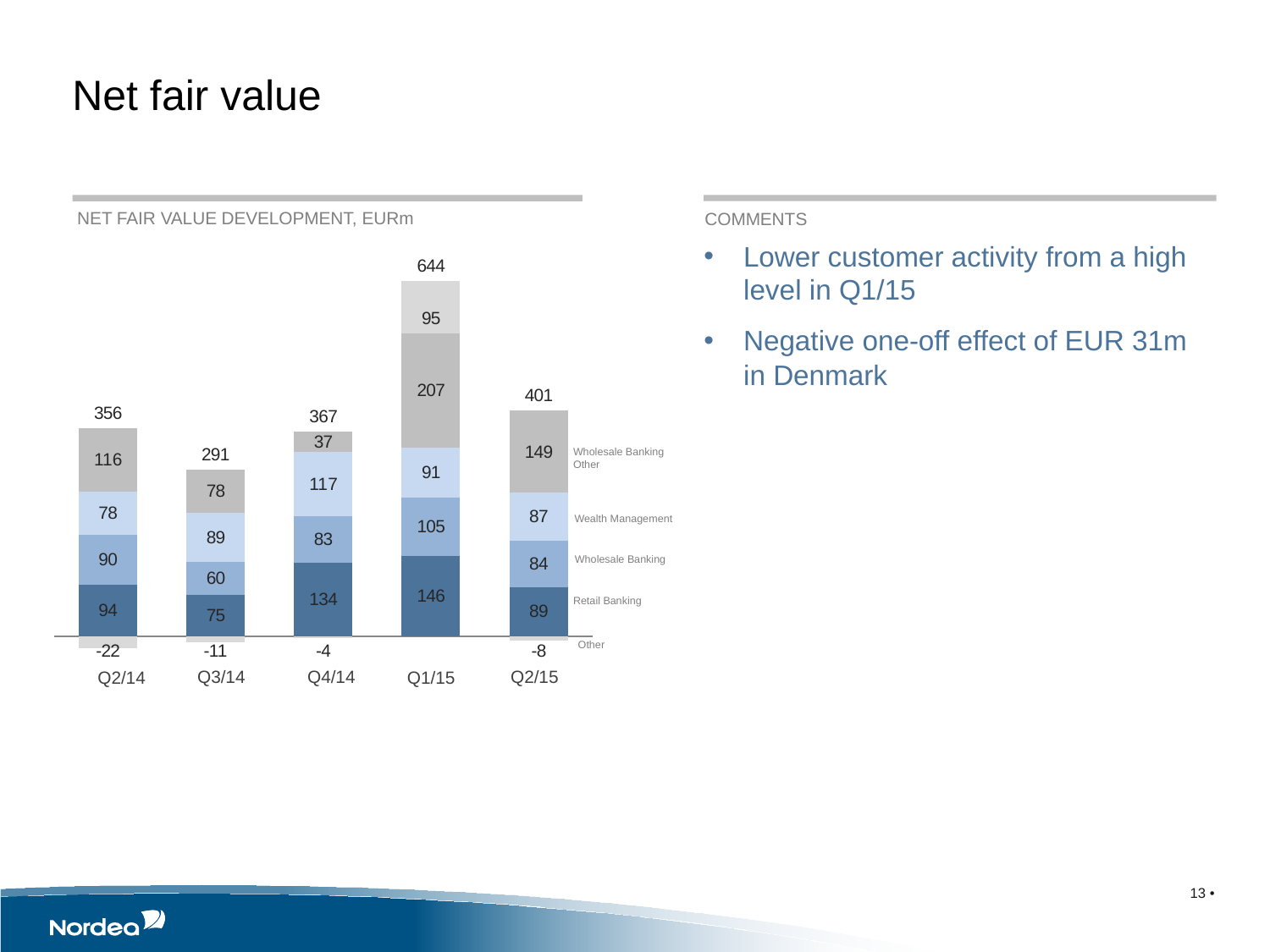
What is the Other value for Q2/14? -22 Which quarter has the highest total net fair value? Q1/15 What kind of chart is shown on the slide? Stacked bar chart What is the Retail Banking value for Q4/14? 134 What is the Wealth Management value for Q3/14? 89 Is the Retail Banking value larger in Q1/15 or Q2/15? Q1/15 Which quarter has the lowest total net fair value? Q3/14 What is the Wholesale Banking Other value for Q2/15? 149 How many quarters are shown on the x axis? 5 What is the difference between the total net fair value in Q1/15 and Q2/15? 243 What is the total net fair value for Q1/15? 644 How many series are labelled in the chart? 5